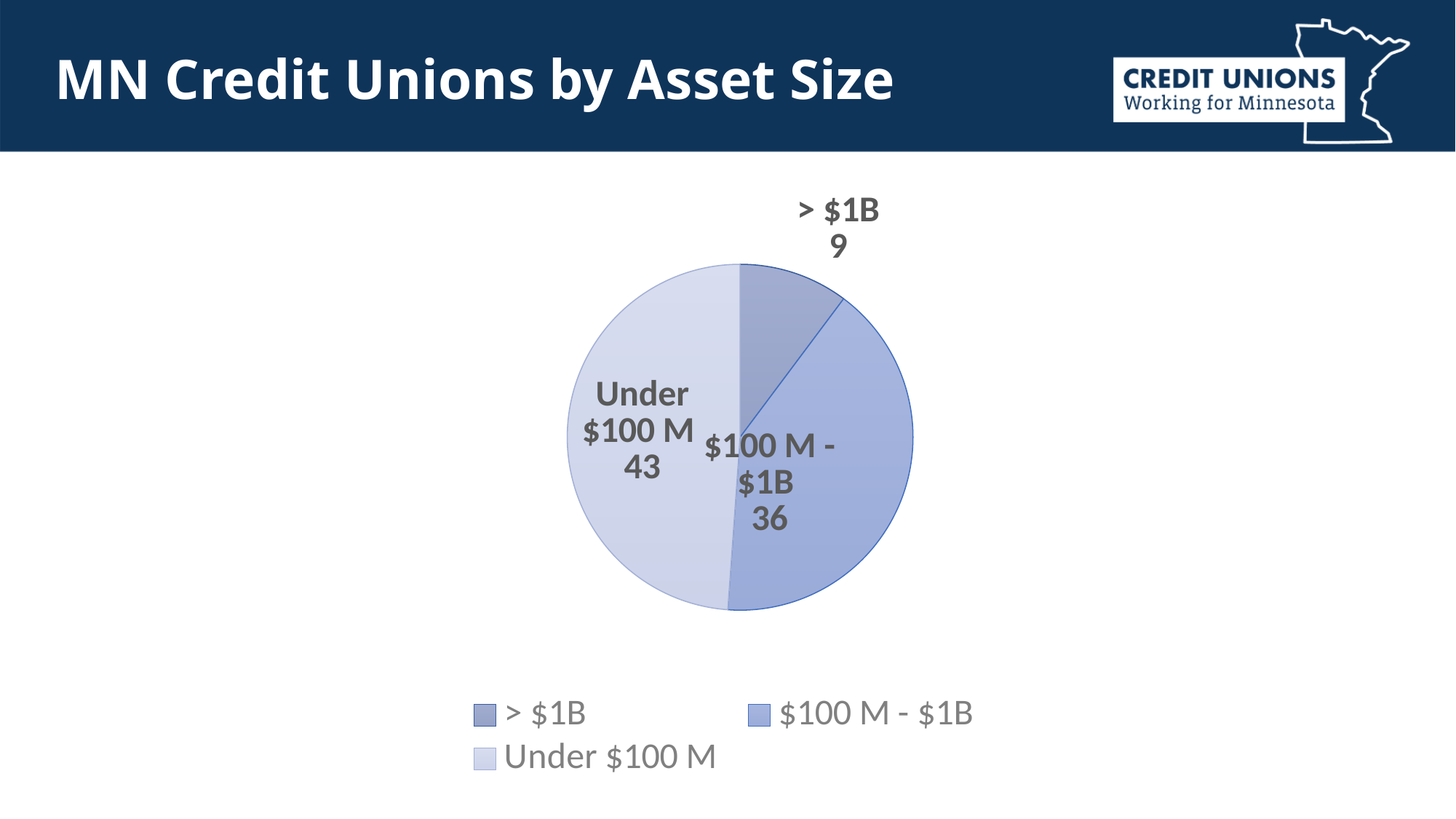
How many categories does the pie chart show? 3 What is the difference between the number of credit unions in the $100 M - $1B category and the > $1B category? 27 What kind of chart is shown on the slide? pie chart Which asset size category has the most credit unions? Under $100 M What is the difference between the number of credit unions Under $100 M and those in the $100 M - $1B category? 7 What is the title of the slide containing the chart? MN Credit Unions by Asset Size Which asset size category has the fewest credit unions? > $1B What is the total number of credit unions across all three categories? 88 Which category has more credit unions, $100 M - $1B or > $1B? $100 M - $1B How many credit unions are in the > $1B category? 9 How many credit unions are in the Under $100 M category? 43 How many credit unions are in the $100 M - $1B category? 36